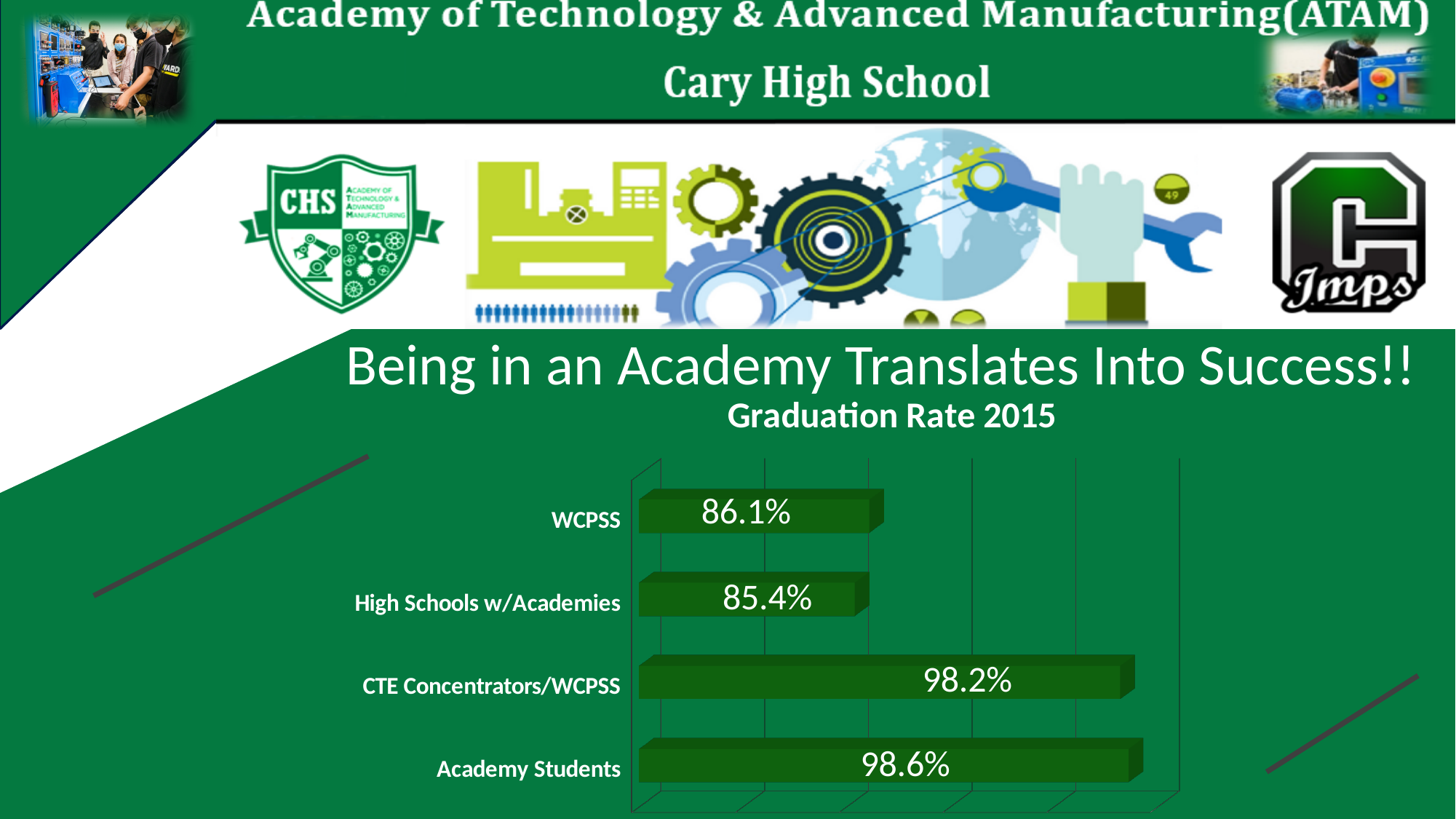
What is the difference between the graduation rates of CTE Concentrators/WCPSS and High Schools w/Academies? 12.8% What kind of chart is shown on the slide? Bar chart Which category has the highest graduation rate? Academy Students How many categories are shown in the chart? 4 Which category has the lowest graduation rate? High Schools w/Academies What is the graduation rate for Academy Students? 98.6% What is the graduation rate for WCPSS? 86.1% What is the difference between the graduation rates of Academy Students and WCPSS? 12.5% What is the graduation rate for CTE Concentrators/WCPSS? 98.2% What is the graduation rate for High Schools w/Academies? 85.4% Which has a higher graduation rate, WCPSS or CTE Concentrators/WCPSS? CTE Concentrators/WCPSS What is the title of the chart? Graduation Rate 2015